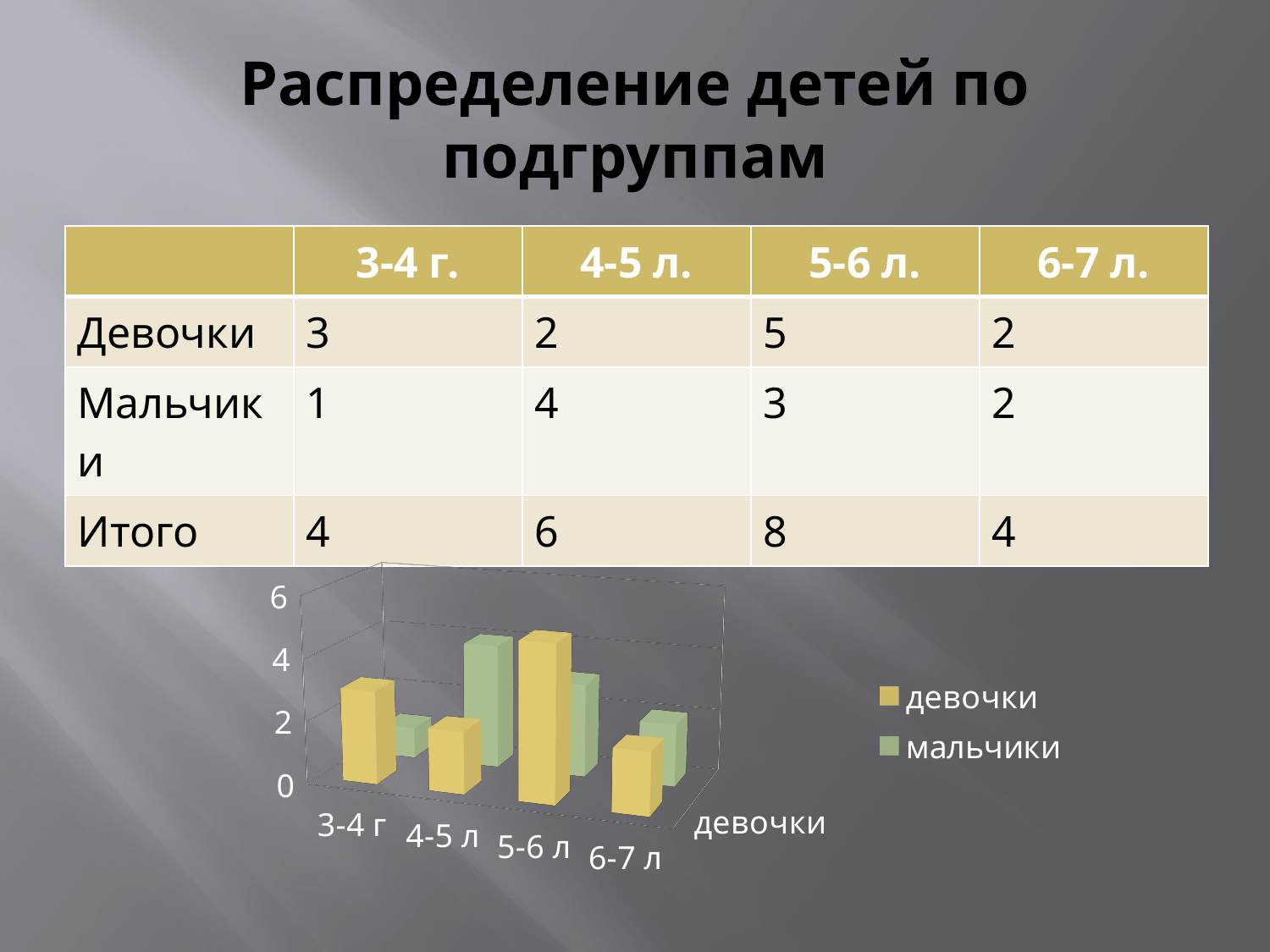
In the 4-5 л group, which is larger: девочки or мальчики? мальчики In the 3-4 л group, which is larger: девочки or мальчики? девочки How many series does the chart legend list? 2 What kind of chart is shown on the slide? bar chart Is the девочки value for 5-6 л greater or less than 4? greater How many age-group categories are shown on the chart's x axis? 4 According to the table on the slide, what is the number of девочки in the 5-6 л group? 5 Is the мальчики value for 3-4 л greater or less than 2? less For which age group is the девочки bar the tallest in the chart? 5-6 л For which age group is the мальчики bar the tallest in the chart? 4-5 л For which age group is the мальчики bar the shortest in the chart? 3-4 г Which series in the chart is shown in yellow? девочки